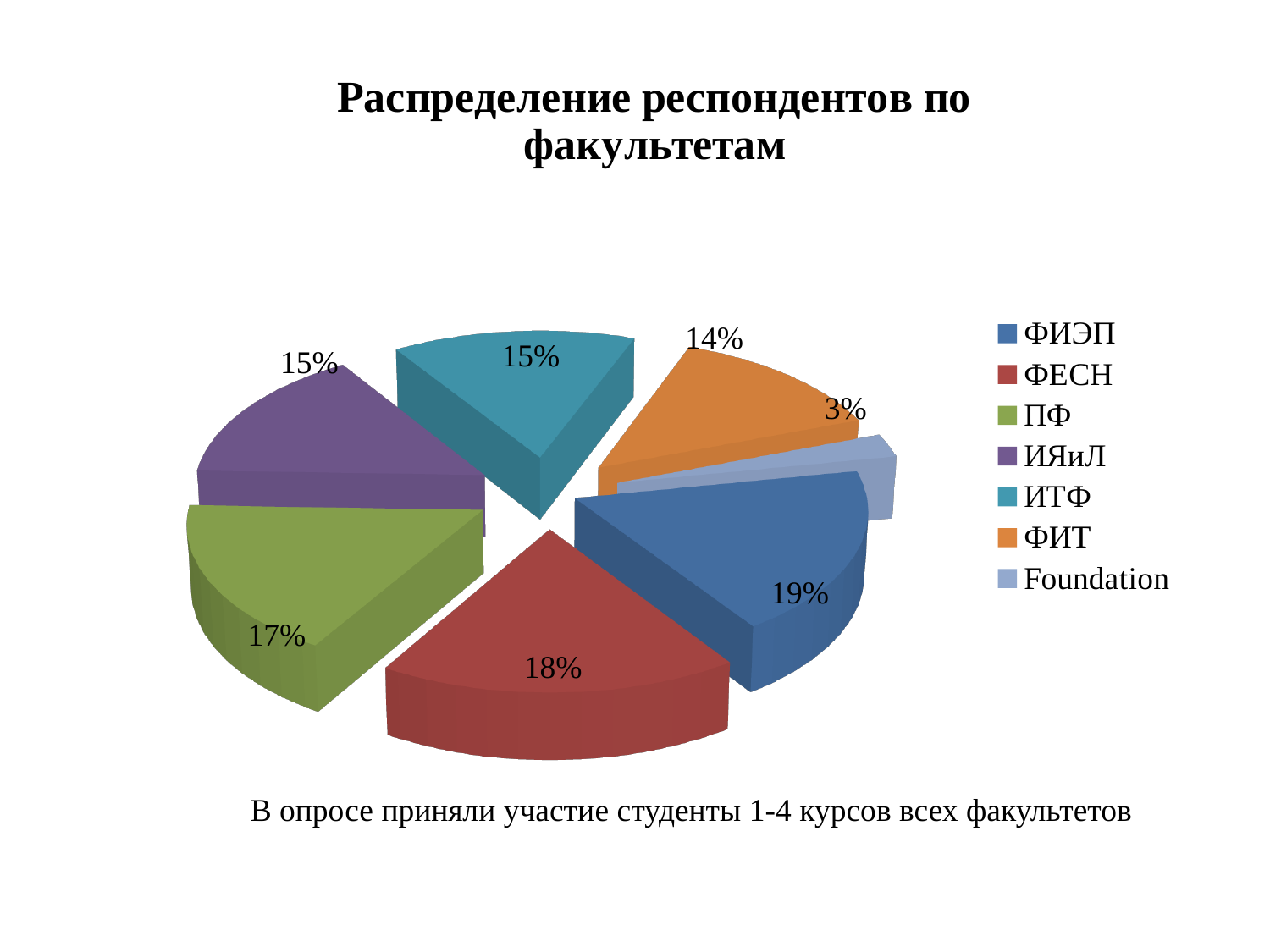
What share of respondents is from ФИЭП? 19% Which faculty has the largest share of respondents? ФИЭП Which has a larger share of respondents, ПФ or ФИТ? ПФ What share of respondents is from ПФ? 17% What is the difference between the shares of ФИЭП and Foundation? 16% What share of respondents is from Foundation? 3% What share of respondents is from ФИТ? 14% What kind of chart is shown on the slide? pie chart Which faculty has the smallest share of respondents? Foundation What share of respondents is from ФЕСН? 18% How many faculties are listed in the legend? 7 What is the title of the chart? Распределение респондентов по факультетам